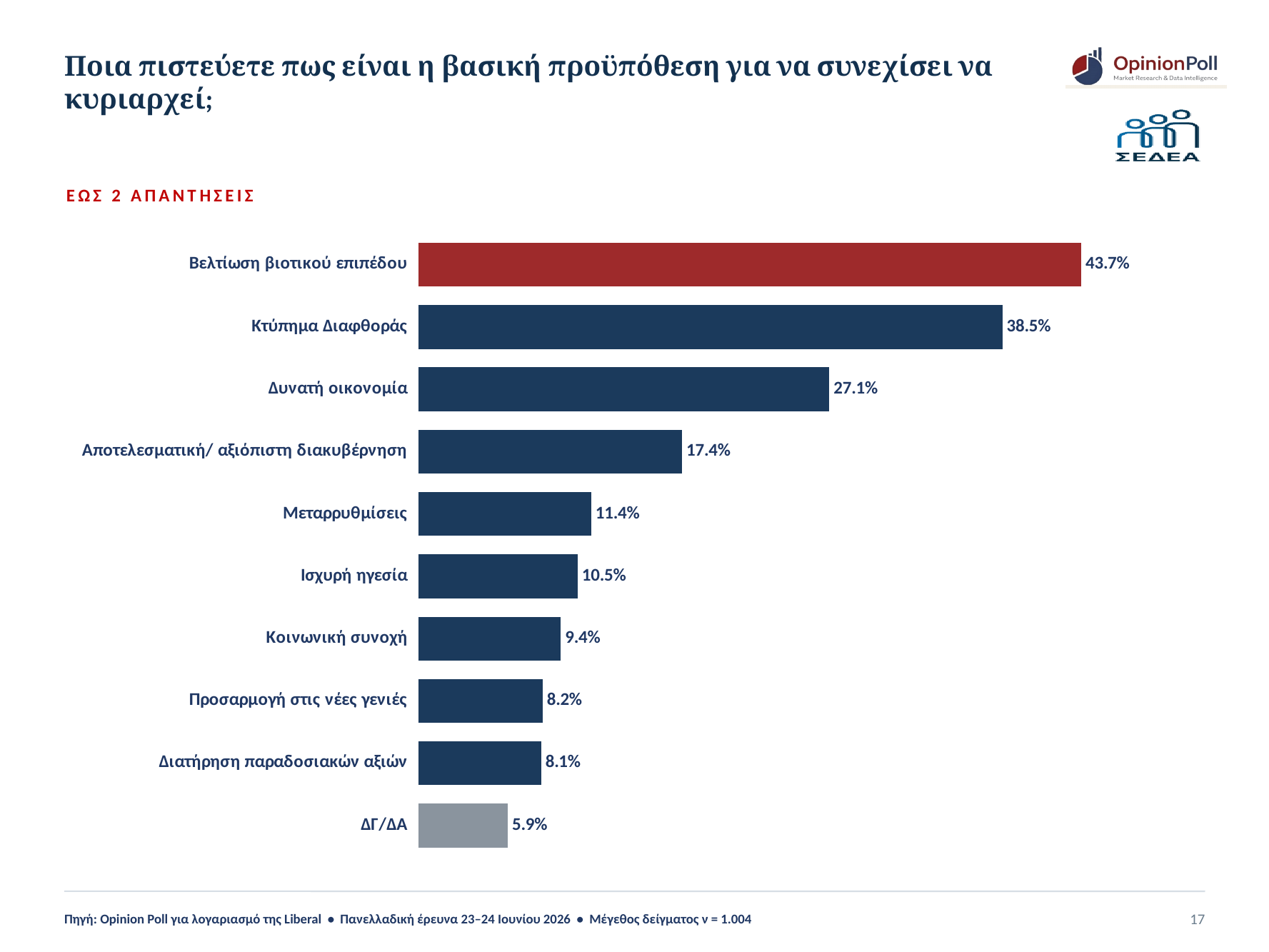
Which category has the highest value? Βελτίωση βιοτικού επιπέδου How many categories are shown in the chart? 10 What is the value for Μεταρρυθμίσεις? 11.4% Which is larger, Ισχυρή ηγεσία or Κοινωνική συνοχή? Ισχυρή ηγεσία What is the value for Βελτίωση βιοτικού επιπέδου? 43.7% What is the value for ΔΓ/ΔΑ? 5.9% What kind of chart is shown on the slide? Bar chart What is the difference between Βελτίωση βιοτικού επιπέδου and Κτύπημα Διαφθοράς? 5.2% Which bar is coloured red? Βελτίωση βιοτικού επιπέδου What is the value for Κτύπημα Διαφθοράς? 38.5% Which category has the lowest value? ΔΓ/ΔΑ What is the difference between Δυνατή οικονομία and Αποτελεσματική/ αξιόπιστη διακυβέρνηση? 9.7%